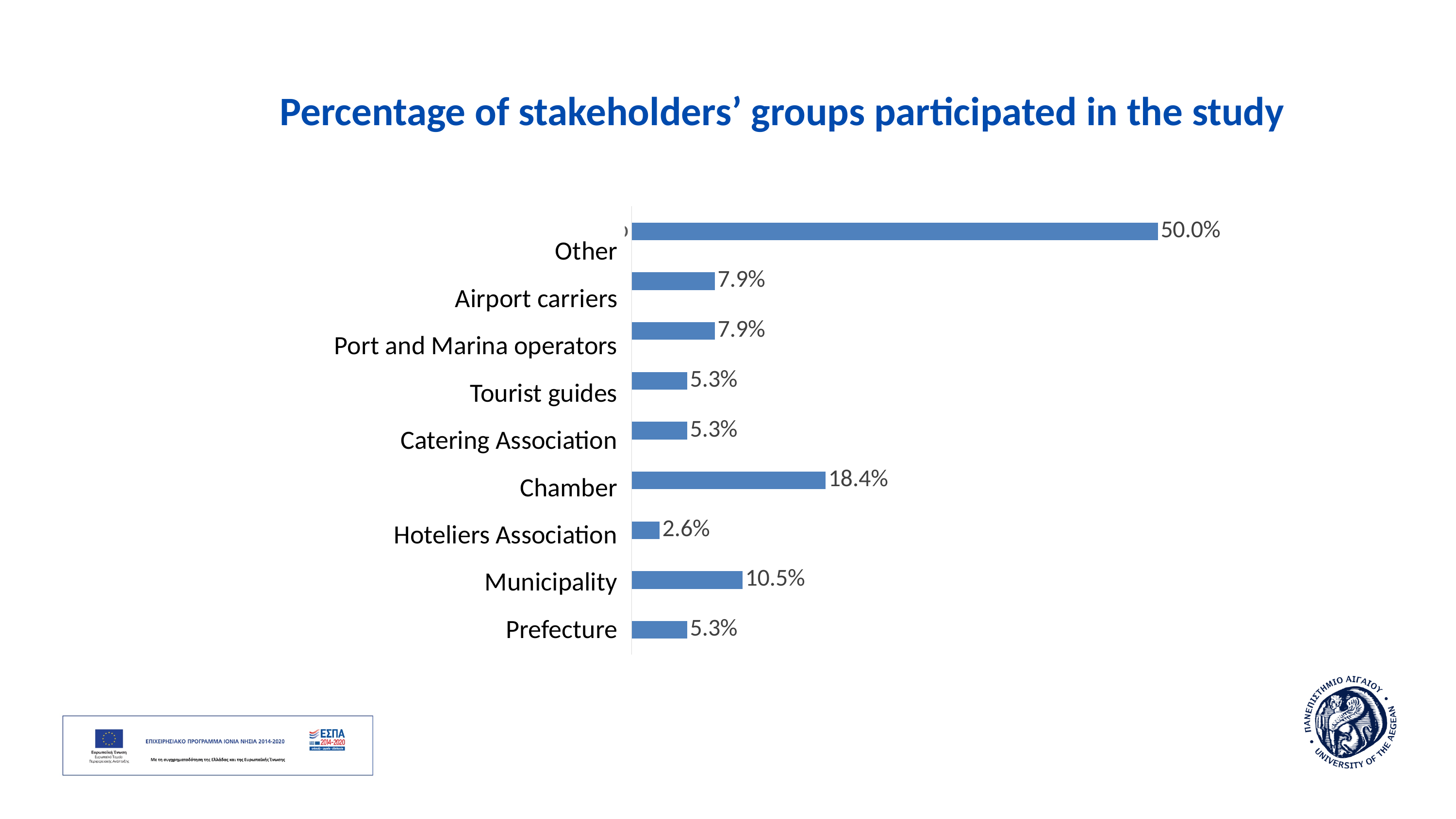
What is the difference between the values for Other and Chamber? 31.6% Which is larger, the value for Chamber or the value for Municipality? Chamber What is the title of the chart? Percentage of stakeholders' groups participated in the study What is the value for Chamber? 18.4% How many categories are shown in the chart? 9 What is the value for Airport carriers? 7.9% What is the value for Municipality? 10.5% What is the value for Hoteliers Association? 2.6% What kind of chart is shown on the slide? Bar chart Which category has the highest value? Other Which category has the lowest value? Hoteliers Association What is the difference between the values for Municipality and Prefecture? 5.2%